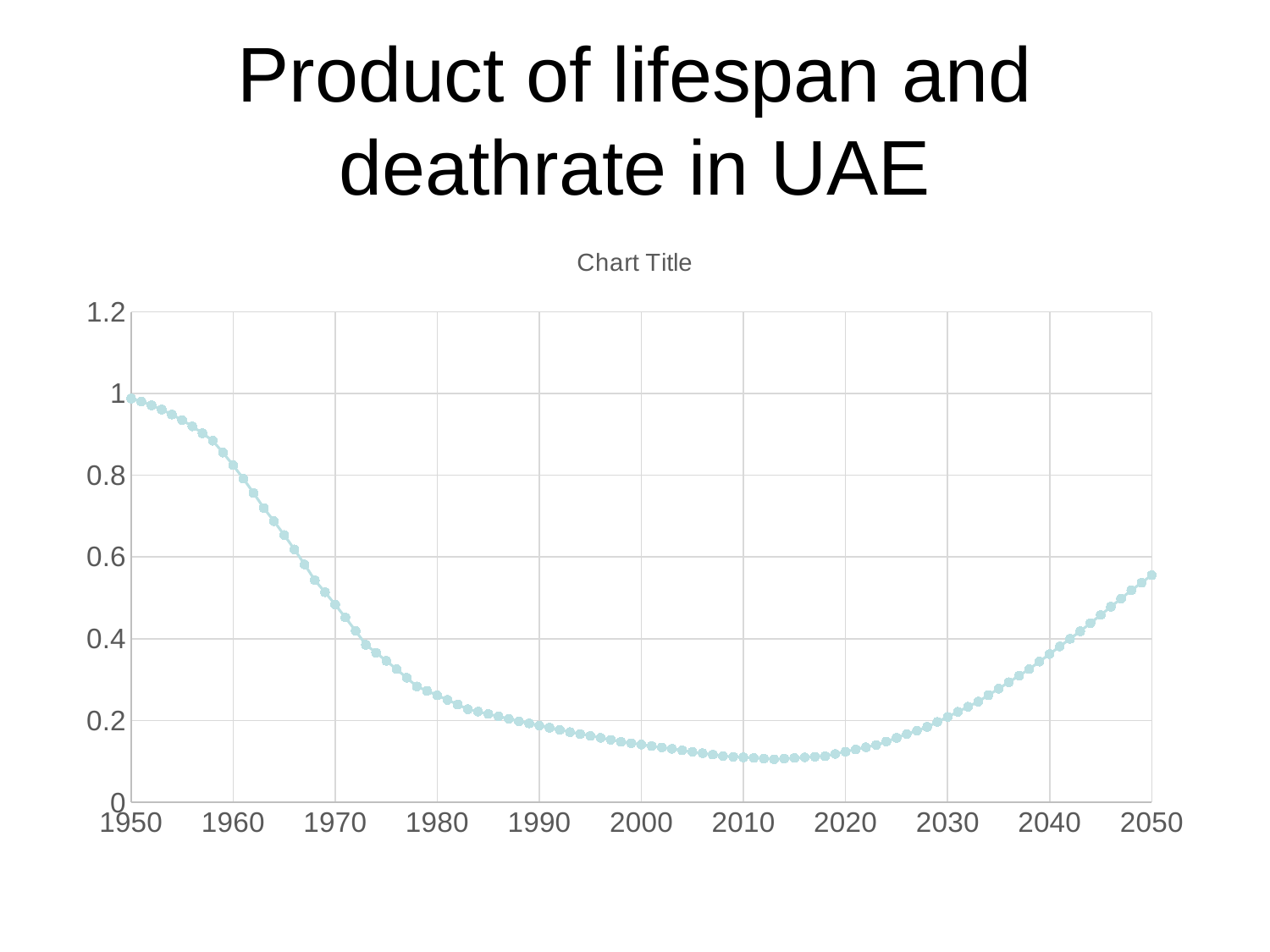
What is the highest value shown on the y axis? 1.2 Is the value for 1970 greater or less than 0.4? greater Do the values rise or fall from 1950 to 2010? fall Do the values rise or fall from 2020 to 2050? rise Is the value for 2010 greater or less than 0.2? less Is the value for 2040 greater or less than 0.4? less What is the title printed above the chart area? Chart Title Which is larger, the value for 1950 or the value for 2050? 1950 Which year has the highest value on the chart? 1950 What kind of chart is shown on the slide? scatter chart